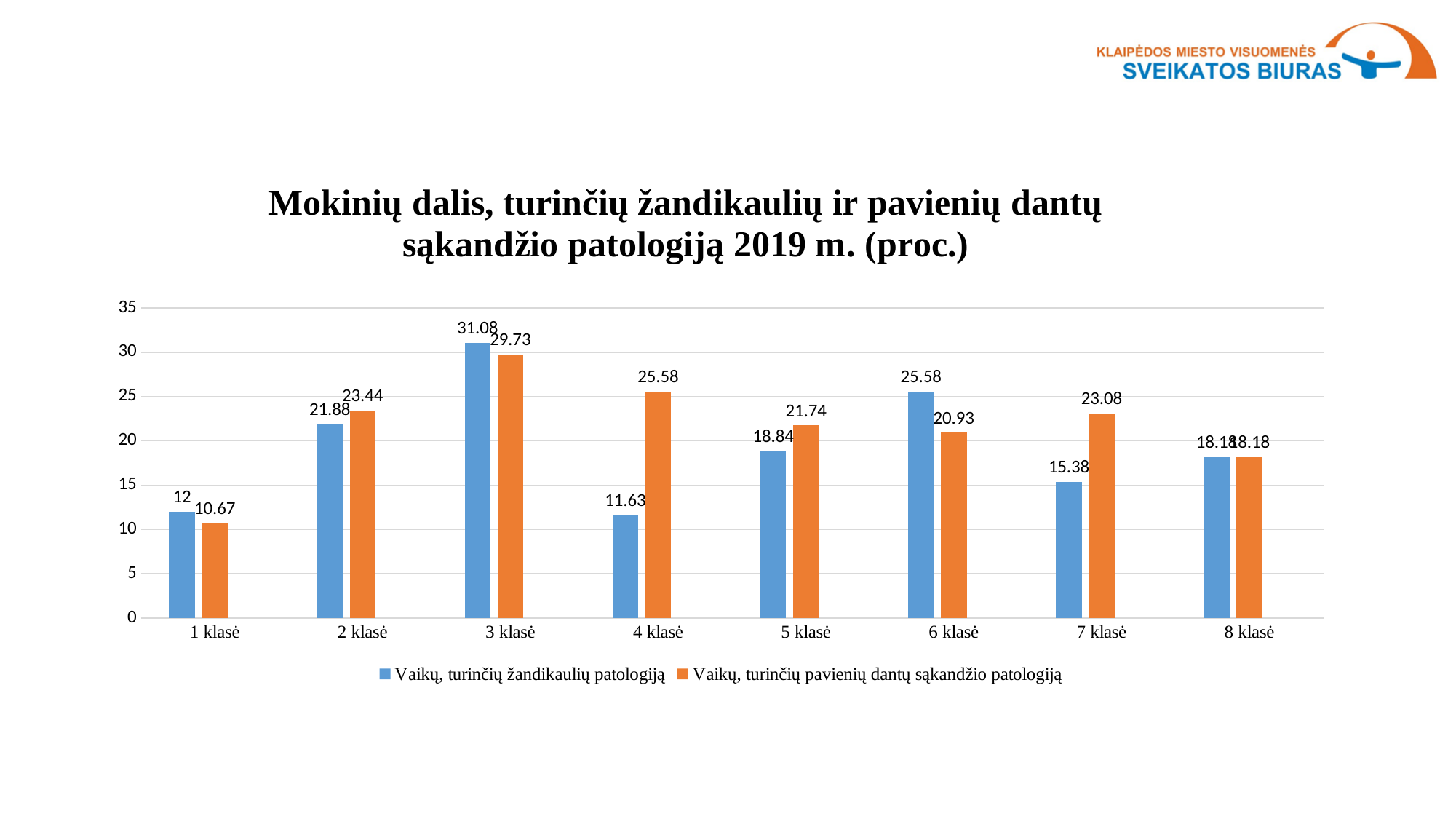
How many classes (categories) are shown on the x axis? 8 Is the value for 2 klasė in the series 'Vaikų, turinčių pavienių dantų sąkandžio patologiją' greater or less than 20? greater What is the value for 7 klasė in the series 'Vaikų, turinčių žandikaulių patologiją'? 15.38 How many series does the legend list? 2 What type of chart is shown on the slide? bar chart Which class has the lowest value in the series 'Vaikų, turinčių pavienių dantų sąkandžio patologiją'? 1 klasė Which class has the highest value in the series 'Vaikų, turinčių žandikaulių patologiją'? 3 klasė What is the value for 3 klasė in the series 'Vaikų, turinčių žandikaulių patologiją'? 31.08 For 6 klasė, which series has the larger value? Vaikų, turinčių žandikaulių patologiją What is the title of the chart? Mokinių dalis, turinčių žandikaulių ir pavienių dantų sąkandžio patologiją 2019 m. (proc.) What is the value for 4 klasė in the series 'Vaikų, turinčių pavienių dantų sąkandžio patologiją'? 25.58 What is the difference between the two series' values for 4 klasė? 13.95